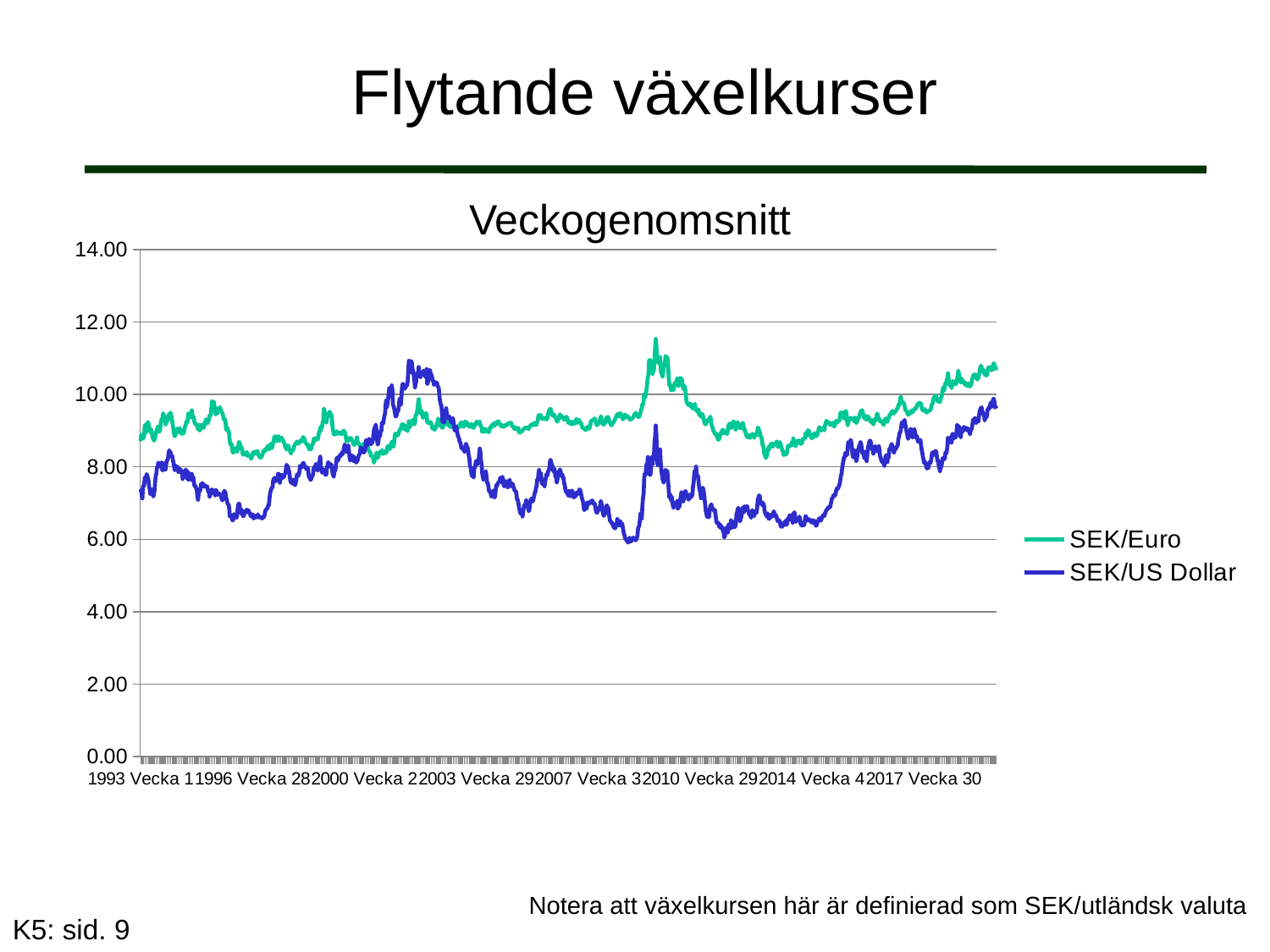
How many labelled tick marks are shown on the x axis? 8 Is the lowest value of the SEK/US Dollar series greater or less than 4.00? greater Which colour is used for the SEK/US Dollar series? blue How many series does the chart legend list? 2 Does the SEK/US Dollar series rise or fall between 2014 Vecka 4 and 2017 Vecka 30? rise At 1993 Vecka 1, which series has the higher value, SEK/Euro or SEK/US Dollar? SEK/Euro What kind of chart is shown on the slide? line chart Is the highest value reached by the SEK/Euro series greater or less than 10.00? greater What is the title of the chart? Veckogenomsnitt Is the value of SEK/Euro at the start of the series (1993 Vecka 1) greater or less than 8.00? greater Which series reaches the highest value anywhere on the chart? SEK/Euro